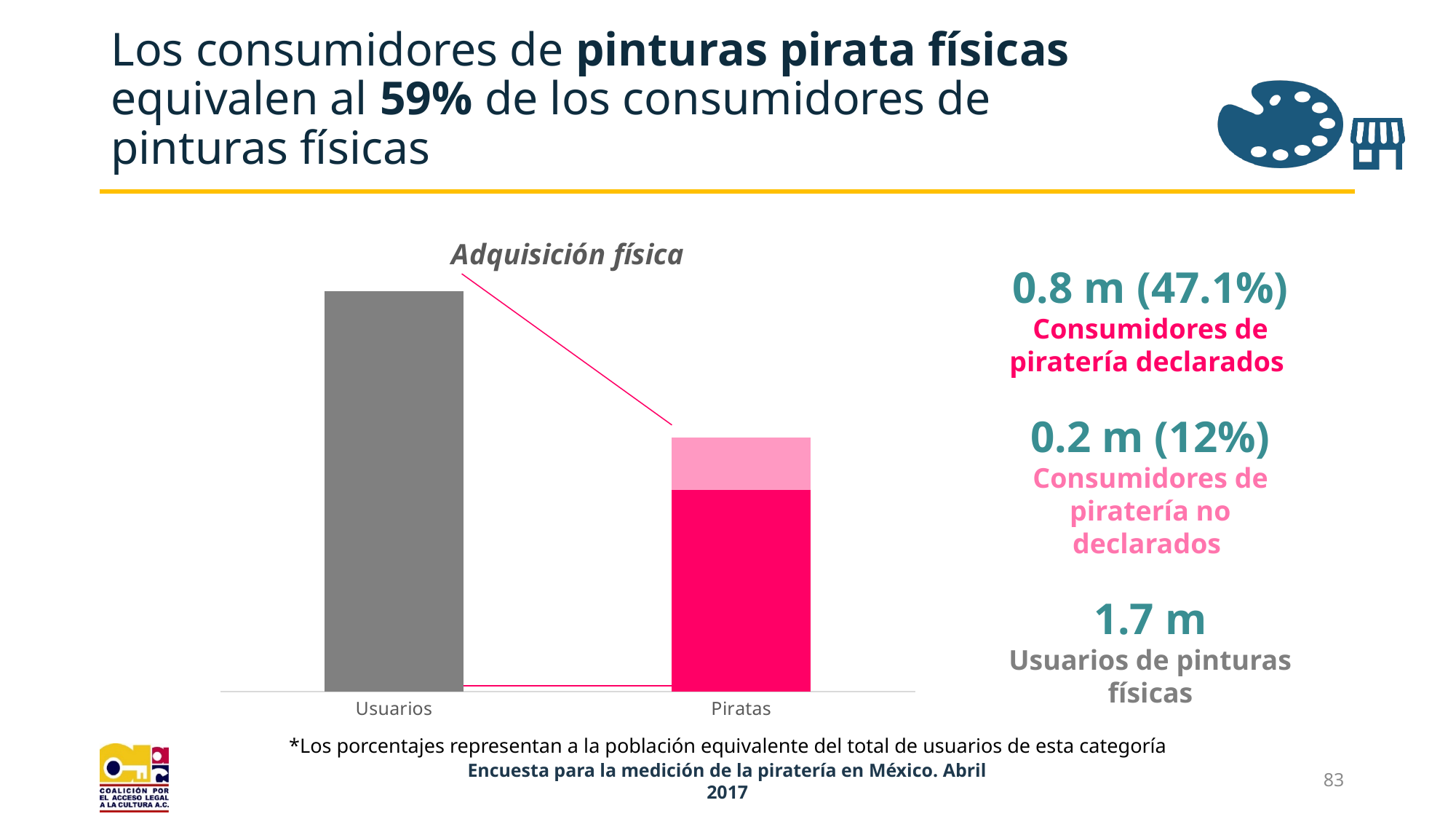
What is the title of the chart? Adquisición física Adding declared (0.8 m) and non-declared (0.2 m) piracy consumers, what is the total for the Piratas bar? 1.0 m Which category has the lowest bar in the chart? Piratas What percentage is shown for declared piracy consumers (Consumidores de piratería declarados)? 47.1% What are the two category labels on the x axis of the chart? Usuarios and Piratas According to the slide title, consumers of physical pirate paintings equal what percentage of consumers of physical paintings? 59% How many categories are shown on the x axis of the chart? 2 Which bar is taller, Usuarios or Piratas? Usuarios What percentage is shown for non-declared piracy consumers (Consumidores de piratería no declarados)? 12% According to the slide, how many declared piracy consumers (Consumidores de piratería declarados) are there? 0.8 m What kind of chart is shown on the slide? bar chart According to the slide, how many users of physical paintings (Usuarios de pinturas físicas) are there? 1.7 m